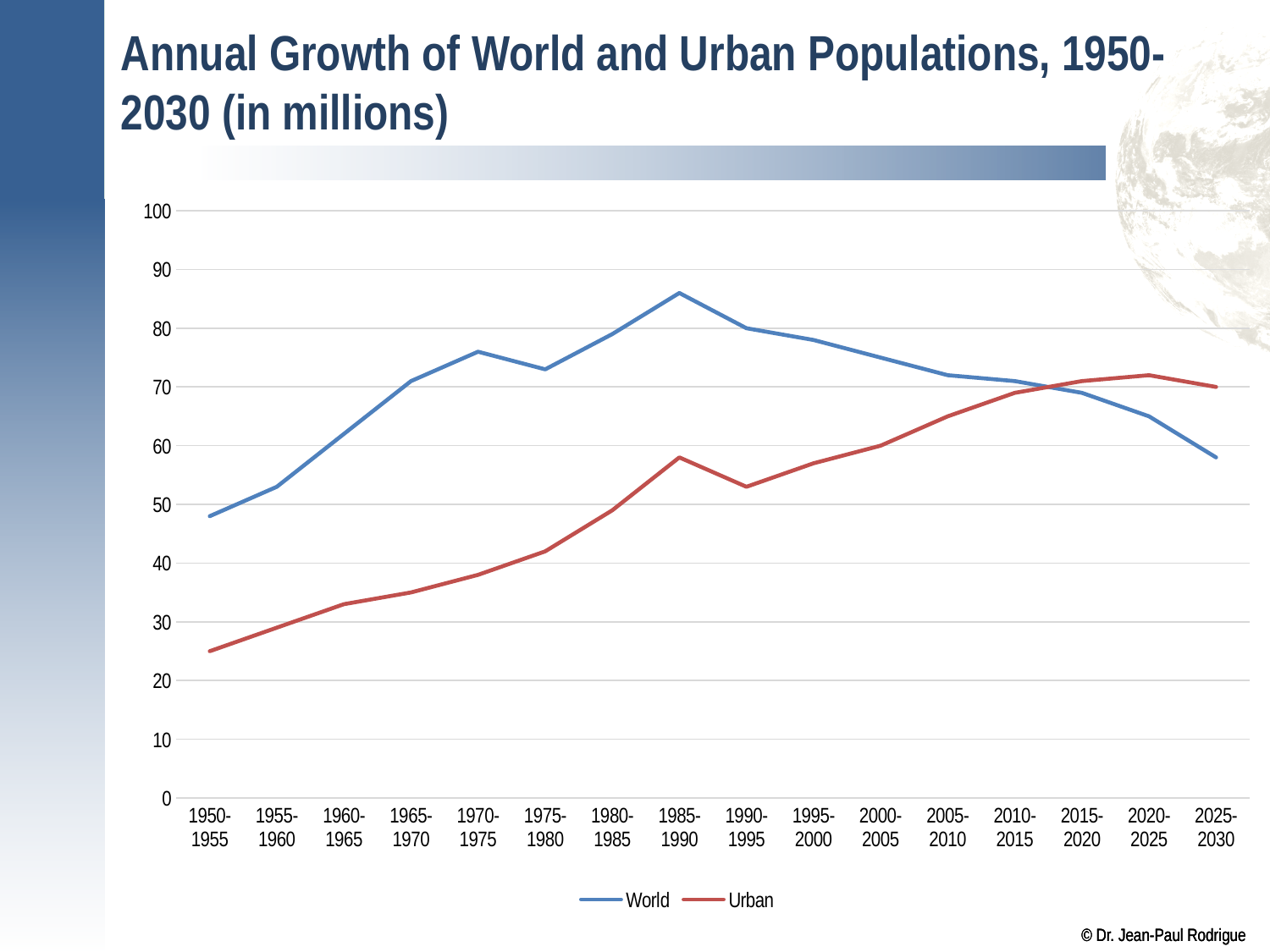
How many time periods are shown along the x axis? 16 In which period is the World series at its lowest value? 1950-1955 In which period does the World series reach its highest value? 1985-1990 Is the value for World in 1985-1990 greater or less than 80? greater How many series does the legend list? 2 Which series has the larger value in 1950-1955, World or Urban? World Does the Urban series rise or fall from 1950-1955 to 1985-1990? rise In which period is the Urban series at its lowest value? 1950-1955 In which period does the Urban series reach its highest value? 2020-2025 What kind of chart is shown on the slide? line chart Is the value for Urban in 1950-1955 greater or less than 30? less Which series has the larger value in 2025-2030, World or Urban? Urban